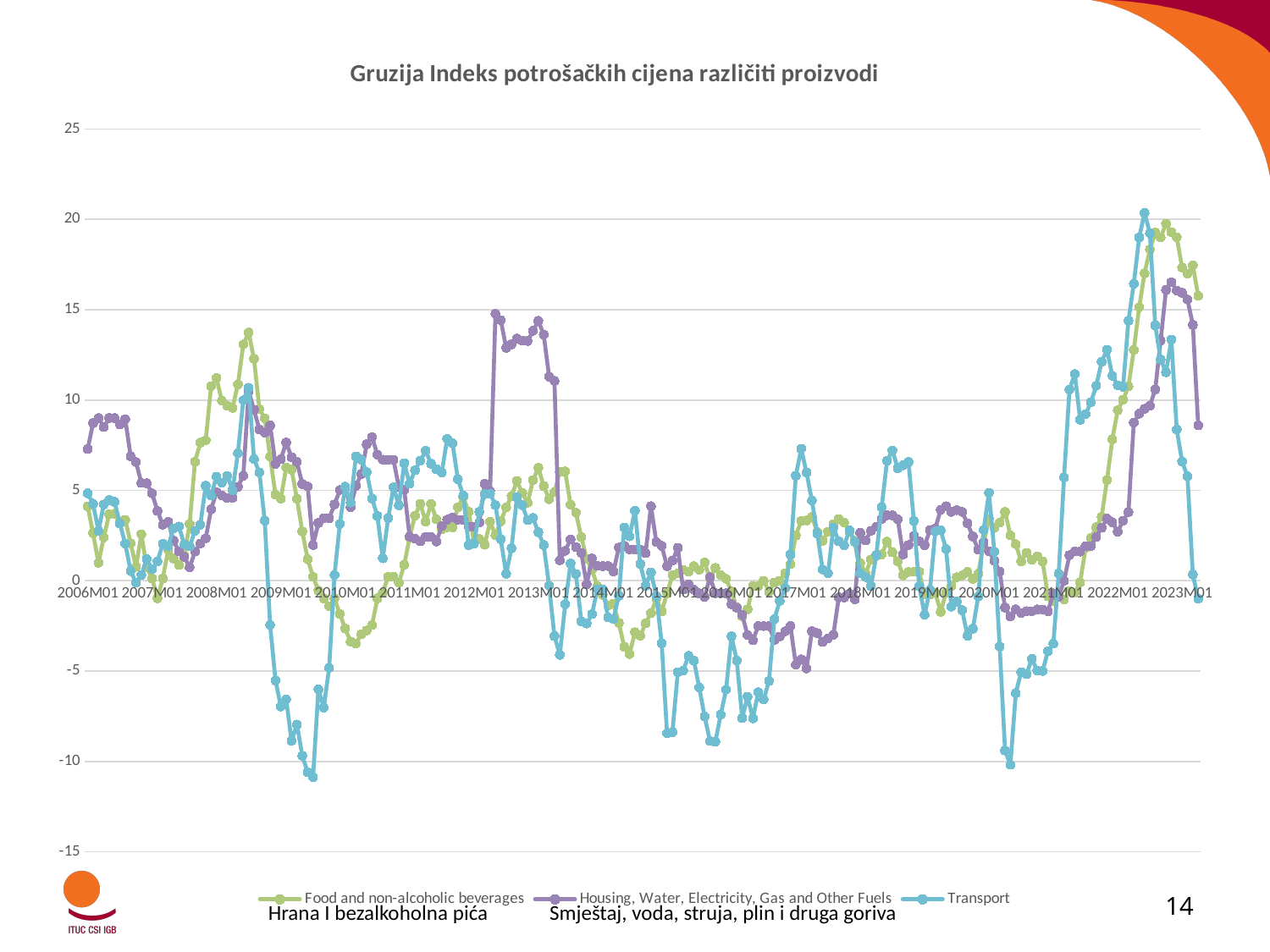
Between 2012M01 and 2013M01, which series has the highest values: Food and non-alcoholic beverages or Housing, Water, Electricity, Gas and Other Fuels? Housing, Water, Electricity, Gas and Other Fuels Is the peak of the Food and non-alcoholic beverages series around 2008 greater or less than 10? greater Does the Food and non-alcoholic beverages series rise or fall between 2021M01 and 2023M01? rise How many series does the legend list? 3 What is the first label on the horizontal axis? 2006M01 What is the title of the chart? Gruzija Indeks potrošačkih cijena različiti proizvodi What is the highest value shown on the vertical axis? 25 Is the lowest value of the Transport series (around 2009) greater or less than -10? less Which series is shown in blue in the legend? Transport Is the value of the Housing, Water, Electricity, Gas and Other Fuels series in mid-2012 greater or less than 10? greater What kind of chart is shown on the slide? line chart Which series reaches the lowest value anywhere on the chart? Transport